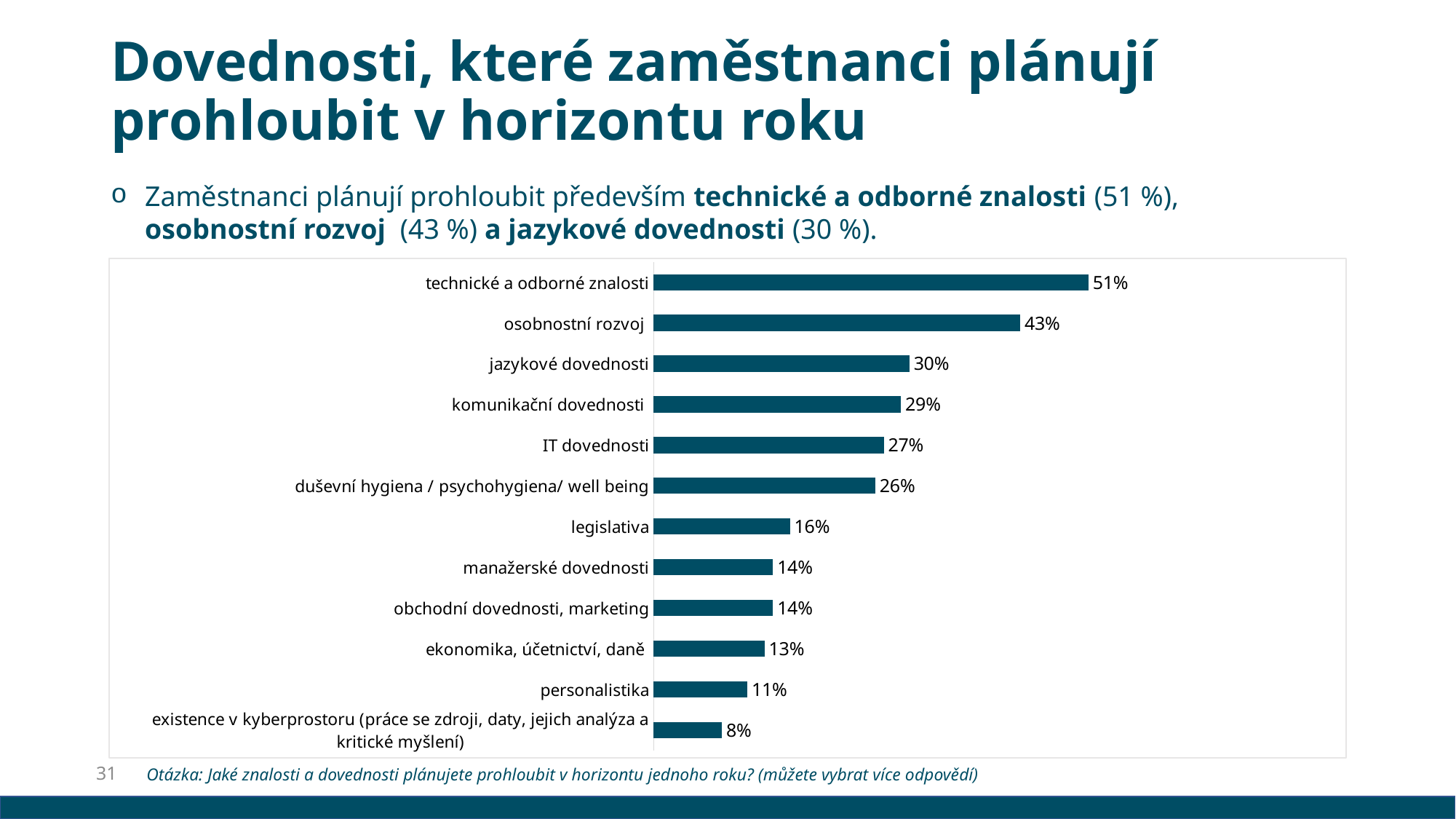
What kind of chart is shown on the slide? bar chart What is the difference between the values for 'osobnostní rozvoj' and 'jazykové dovednosti'? 13% Which is larger, the value for 'legislativa' or the value for 'ekonomika, účetnictví, daně'? legislativa What is the value for 'personalistika'? 11% Which category has the lowest value? existence v kyberprostoru (práce se zdroji, daty, jejich analýza a kritické myšlení) Which category has the highest value? technické a odborné znalosti How many categories are shown in the chart? 12 What is the difference between the values for 'technické a odborné znalosti' and 'existence v kyberprostoru (práce se zdroji, daty, jejich analýza a kritické myšlení)'? 43% Which two categories both have a value of 14%? manažerské dovednosti and obchodní dovednosti, marketing What is the value for 'IT dovednosti'? 27% What is the value for 'duševní hygiena / psychohygiena/ well being'? 26% What is the value for 'technické a odborné znalosti'? 51%